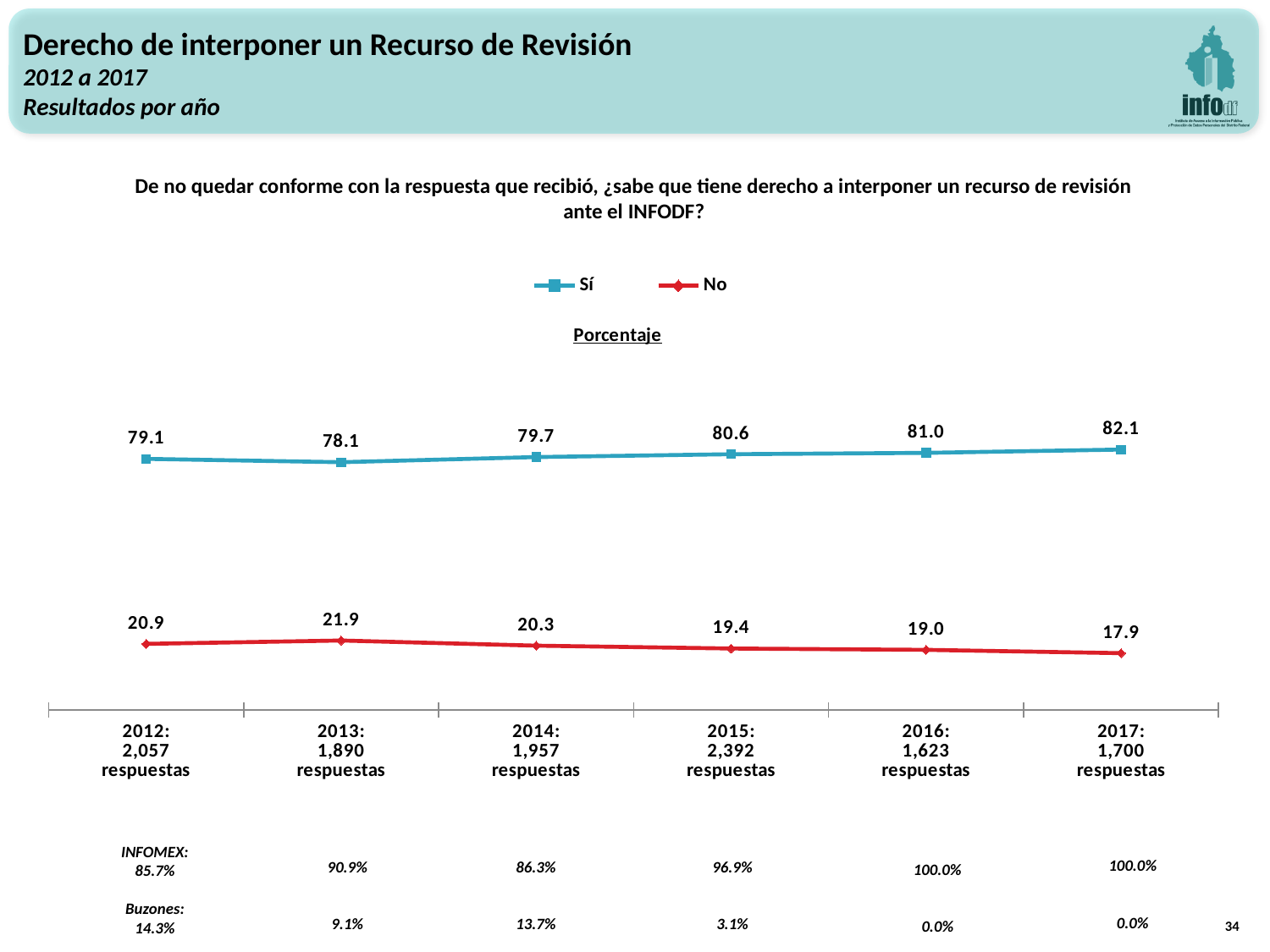
In which year is the 'Sí' series lowest? 2013 What kind of chart is shown? Line chart How many series does the legend list? 2 What is the value of the 'Sí' series for 2012? 79.1 What is the difference between the 'Sí' value in 2017 and the 'Sí' value in 2012? 3.0 In which year is the 'Sí' series highest? 2017 How many years are shown on the x axis? 6 In which year is the 'No' series highest? 2013 Which is larger in 2015: the 'Sí' value or the 'No' value? Sí Does the 'No' series rise or fall from 2013 to 2017? Fall What is the value of the 'No' series for 2013? 21.9 What is the value of the 'No' series for 2017? 17.9